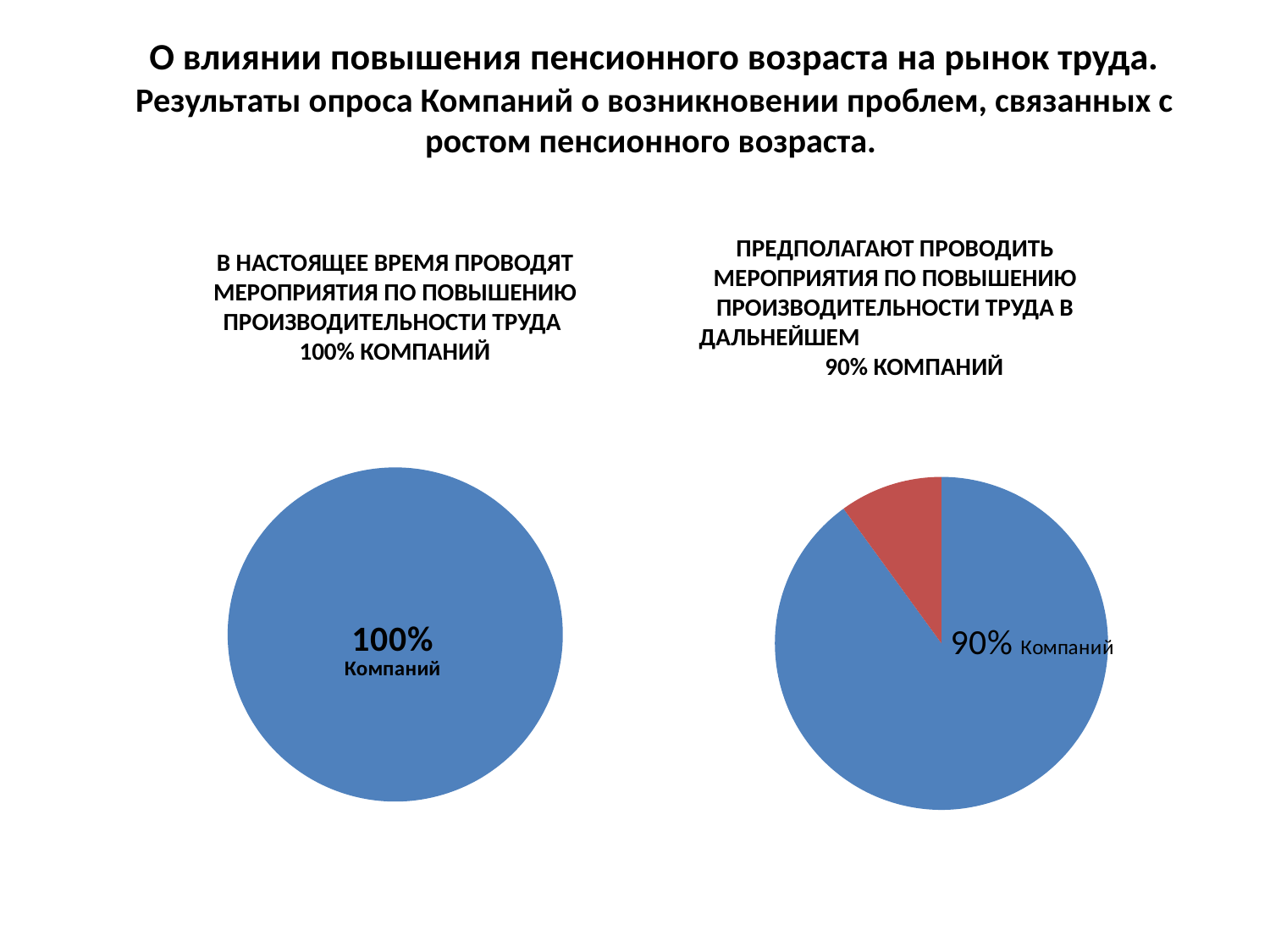
What kind of chart is the right chart on the slide? pie chart In the right pie chart, what value is printed on the blue slice? 90% What colour is the slice in the left pie chart? blue In the left pie chart, what value is printed on the slice? 100% What percentage of companies is stated in the heading above the right pie chart? 90% КОМПАНИЙ How many slices does the right pie chart have? 2 What kind of chart is the left chart on the slide? pie chart How many slices does the left pie chart have? 1 In the right pie chart, which slice is larger, the blue one or the red one? the blue one Which chart shows the larger labelled share of companies, the left pie chart or the right pie chart? the left pie chart What is the difference between the labelled share in the left pie chart and the labelled share in the right pie chart? 10%